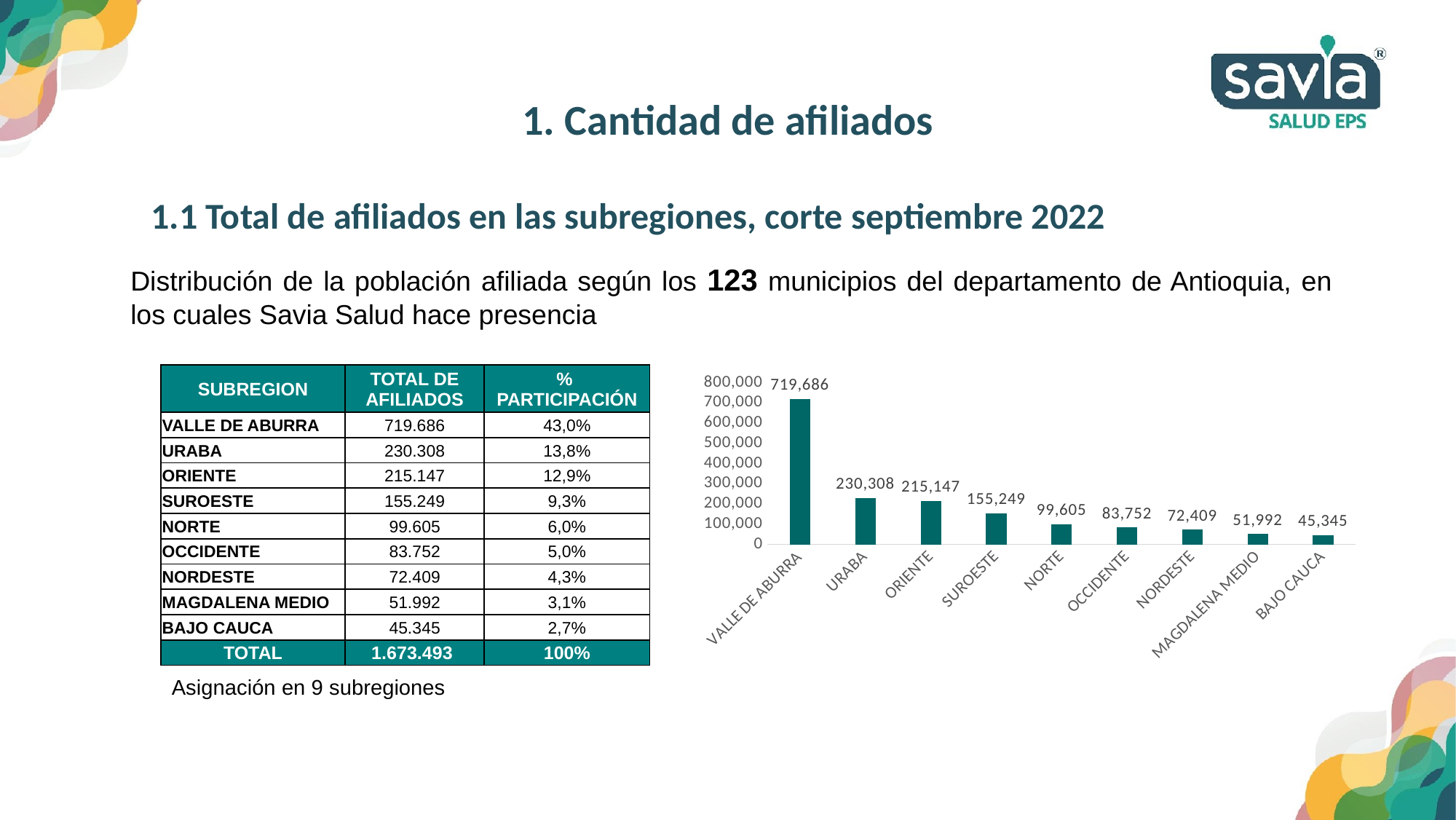
What is the difference between the values for MAGDALENA MEDIO and BAJO CAUCA in the chart? 6,647 Is the value for NORDESTE in the chart greater or less than 100,000? less What is the difference between the values for URABA and ORIENTE in the chart? 15,161 What is the value shown for VALLE DE ABURRA in the chart? 719,686 Which subregion has the lowest value in the chart? BAJO CAUCA How many subregions are plotted in the chart? 9 What is the value shown for NORTE in the chart? 99,605 Which subregion has the highest value in the chart? VALLE DE ABURRA What is the value shown for MAGDALENA MEDIO in the chart? 51,992 Which has a larger value in the chart, SUROESTE or OCCIDENTE? SUROESTE What kind of chart is shown on the slide? bar chart Do the values in the chart rise or fall from left to right along the x axis? fall